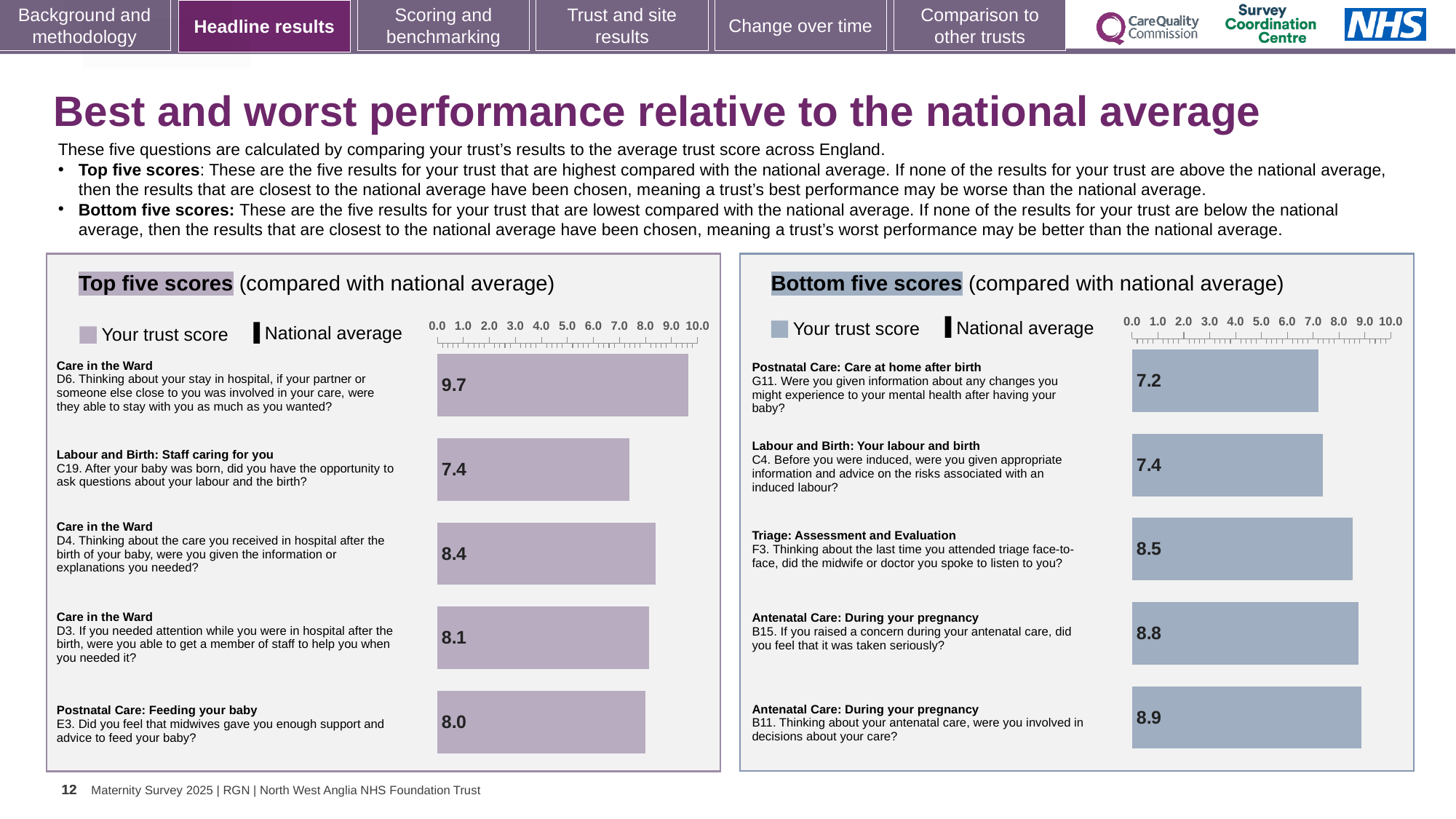
In the Top five scores chart, what is the difference between the trust scores for D6 and C19? 2.3 In the Top five scores chart, which question has the highest trust score? D6 (Care in the Ward) In the Bottom five scores chart, which has the larger trust score, F3 or B15? B15 How many bars are shown in the Top five scores chart? 5 In the Bottom five scores chart, which question has the highest trust score? B11 (Antenatal Care: During your pregnancy) In the Bottom five scores chart, what is the trust score for question G11 (Postnatal Care: Care at home after birth)? 7.2 In the Bottom five scores chart, which question has the lowest trust score? G11 (Postnatal Care: Care at home after birth) In the Bottom five scores chart, what is the difference between the trust scores for B11 and G11? 1.7 In the Top five scores chart, which question has the lowest trust score? C19 (Labour and Birth: Staff caring for you) In the Top five scores chart, what is the trust score for question E3 (Postnatal Care: Feeding your baby)? 8.0 What type of chart is the Bottom five scores chart? Bar chart In the Top five scores chart, what is the trust score for question D6 (Care in the Ward)? 9.7